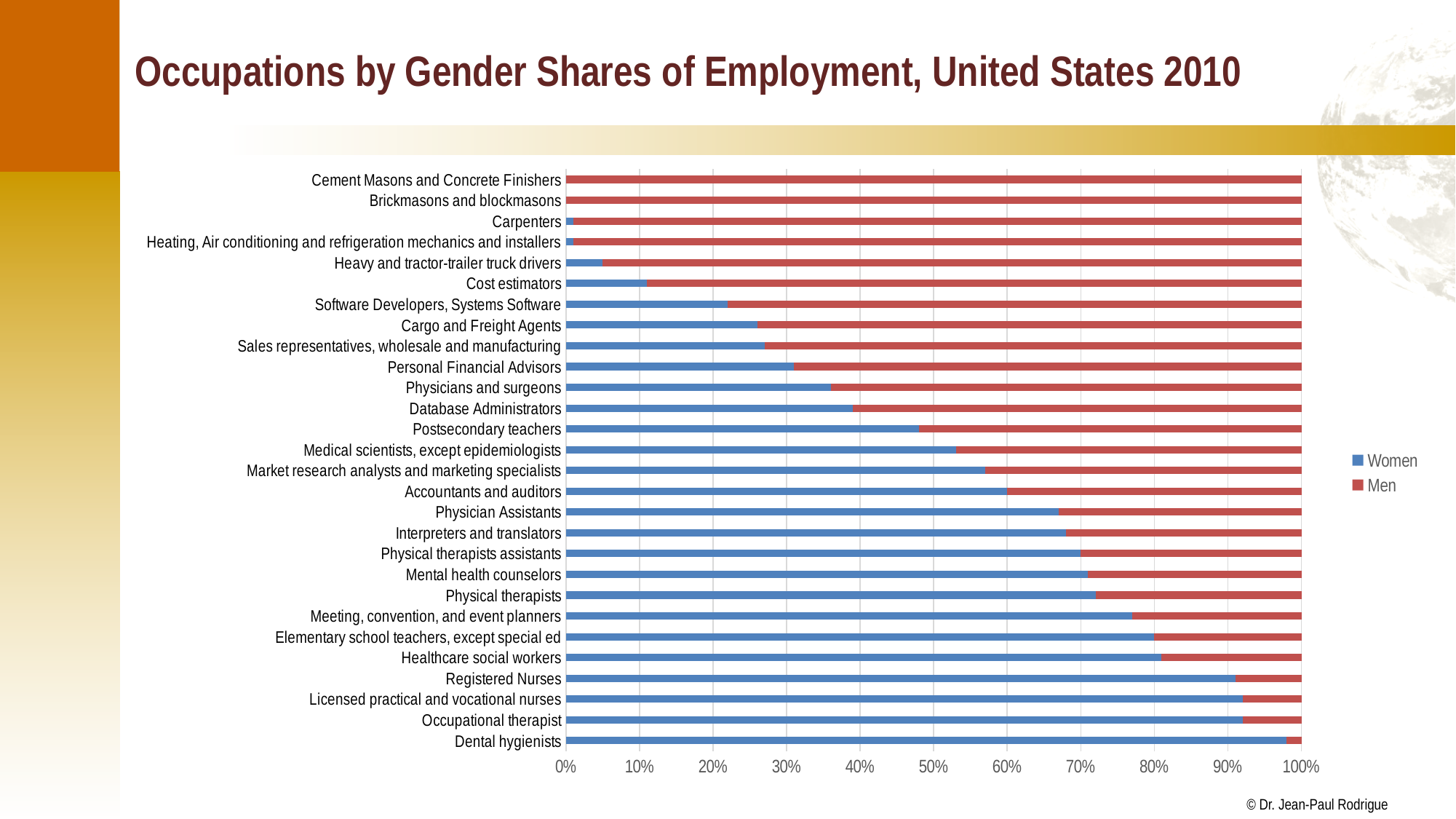
What do the Women and Men segments for Registered Nurses add up to? 100% Is the Women share for Meeting, convention, and event planners greater or less than 70%? greater Which has a larger Women share: Physicians and surgeons or Postsecondary teachers? Postsecondary teachers Which has a larger Men share: Carpenters or Cost estimators? Carpenters How many series does the legend list? 2 How many occupations are plotted in the chart? 28 Is the Women share for Heavy and tractor-trailer truck drivers greater or less than 10%? less Which occupation has the highest share of women? Dental hygienists Is the Women share for Dental hygienists greater or less than 90%? greater What are the two series named in the legend? Women and Men What kind of chart is shown on the slide? Stacked bar chart